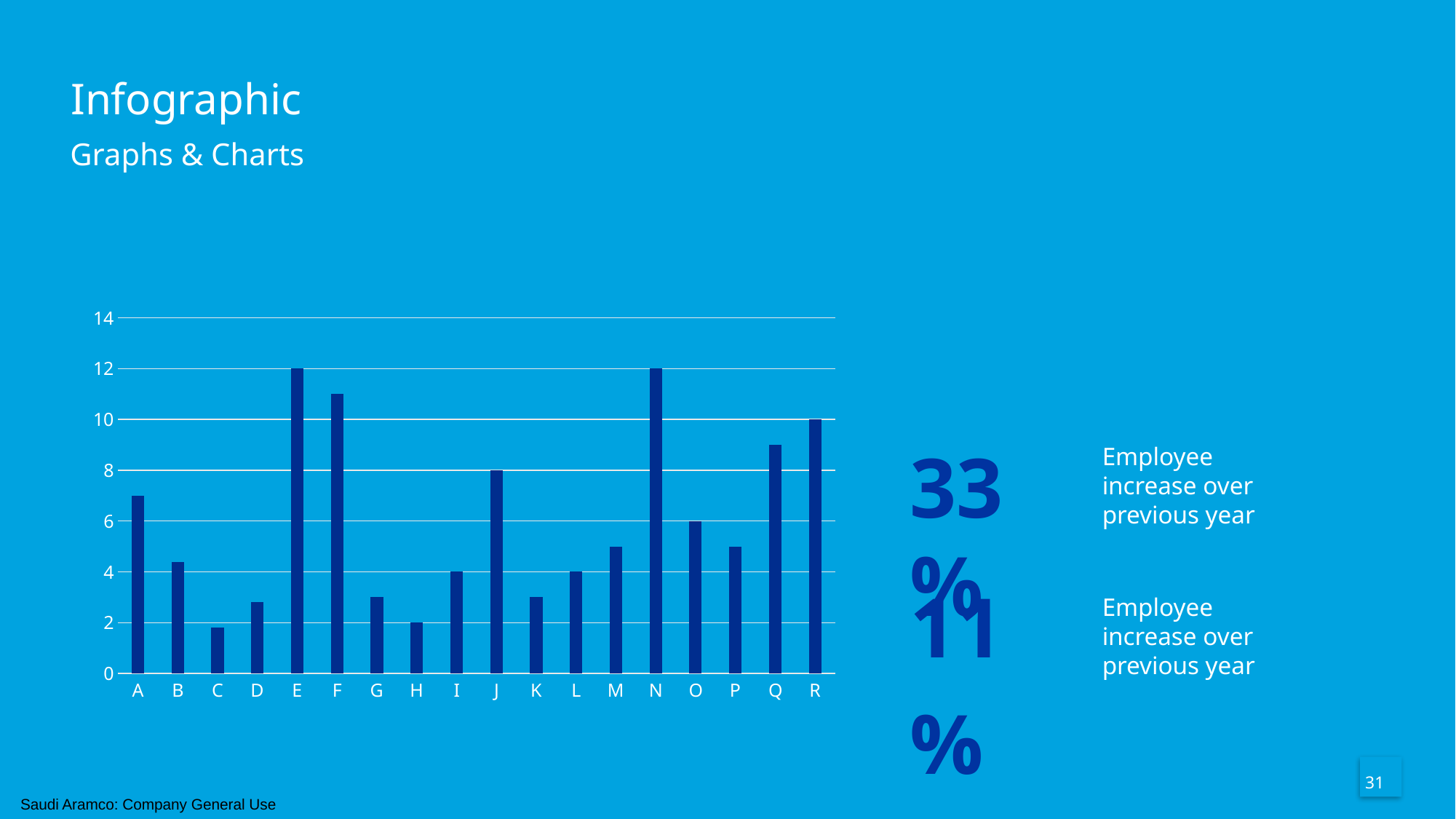
Which has the larger value, category E or category A? E What kind of chart is shown on the slide? bar chart Is the value for F greater or less than 10? greater How many categories are shown on the x axis of the bar chart? 18 Which has the larger value, category J or category G? J What is the value for category R in the bar chart? 10 What colour are the bars in the chart? dark blue What is the value for category E in the bar chart? 12 Is the value for Q greater or less than 8? greater Is the value for A greater or less than 6? greater